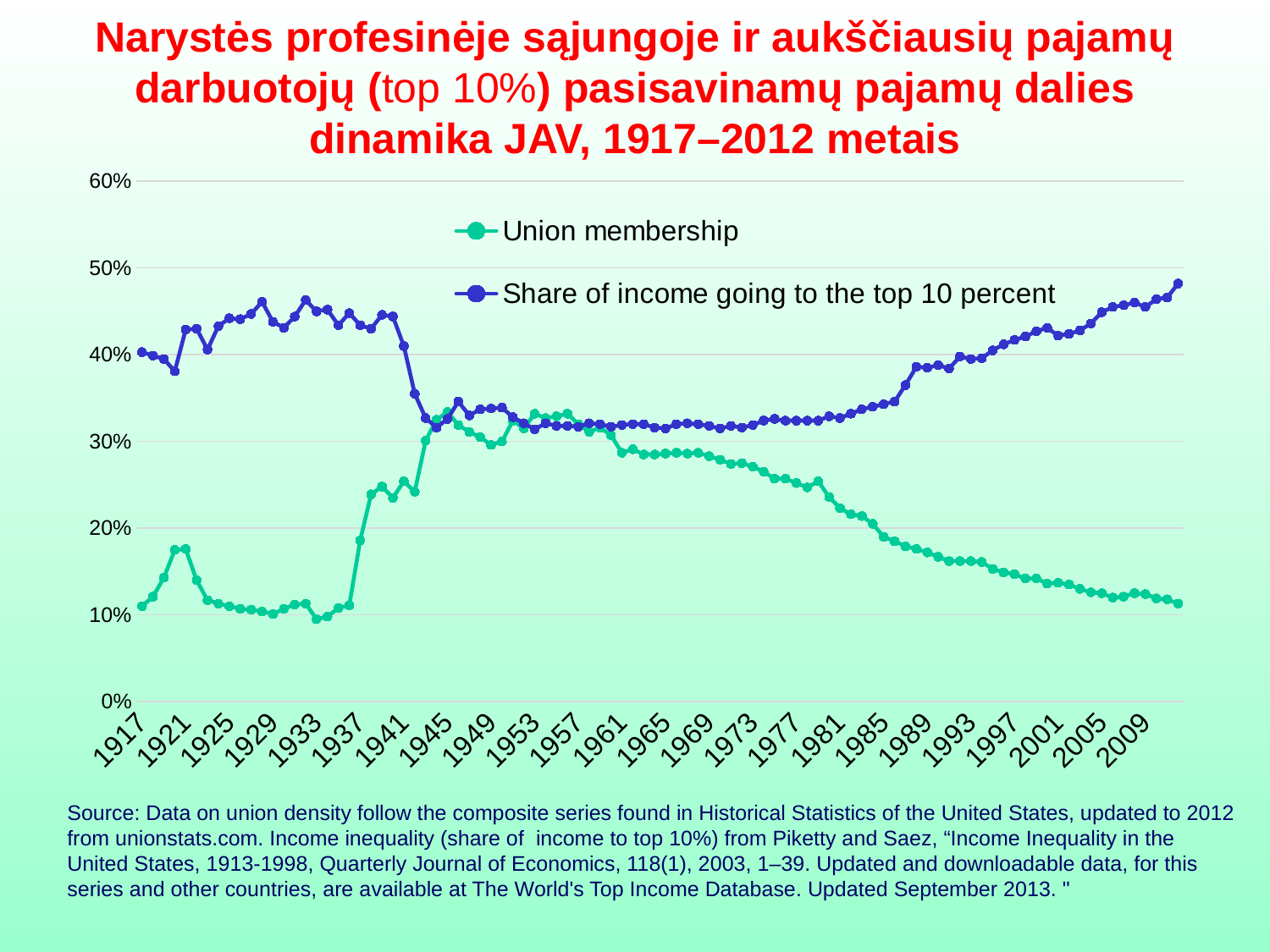
How many series does the legend list? 2 Is the value for Share of income going to the top 10 percent in 2009 greater or less than 40%? greater What are the two series named in the legend? Union membership; Share of income going to the top 10 percent What is the highest value shown on the vertical axis? 60% What kind of chart is shown on the slide? line chart Does the Union membership series rise or fall between 1981 and 2009? fall Is the value for Share of income going to the top 10 percent in 1973 greater or less than 40%? less Is the value for Share of income going to the top 10 percent in 1929 greater or less than 40%? greater In 1929, which series has the larger value: Union membership or Share of income going to the top 10 percent? Share of income going to the top 10 percent Does the Share of income going to the top 10 percent series rise or fall between 1985 and 2009? rise